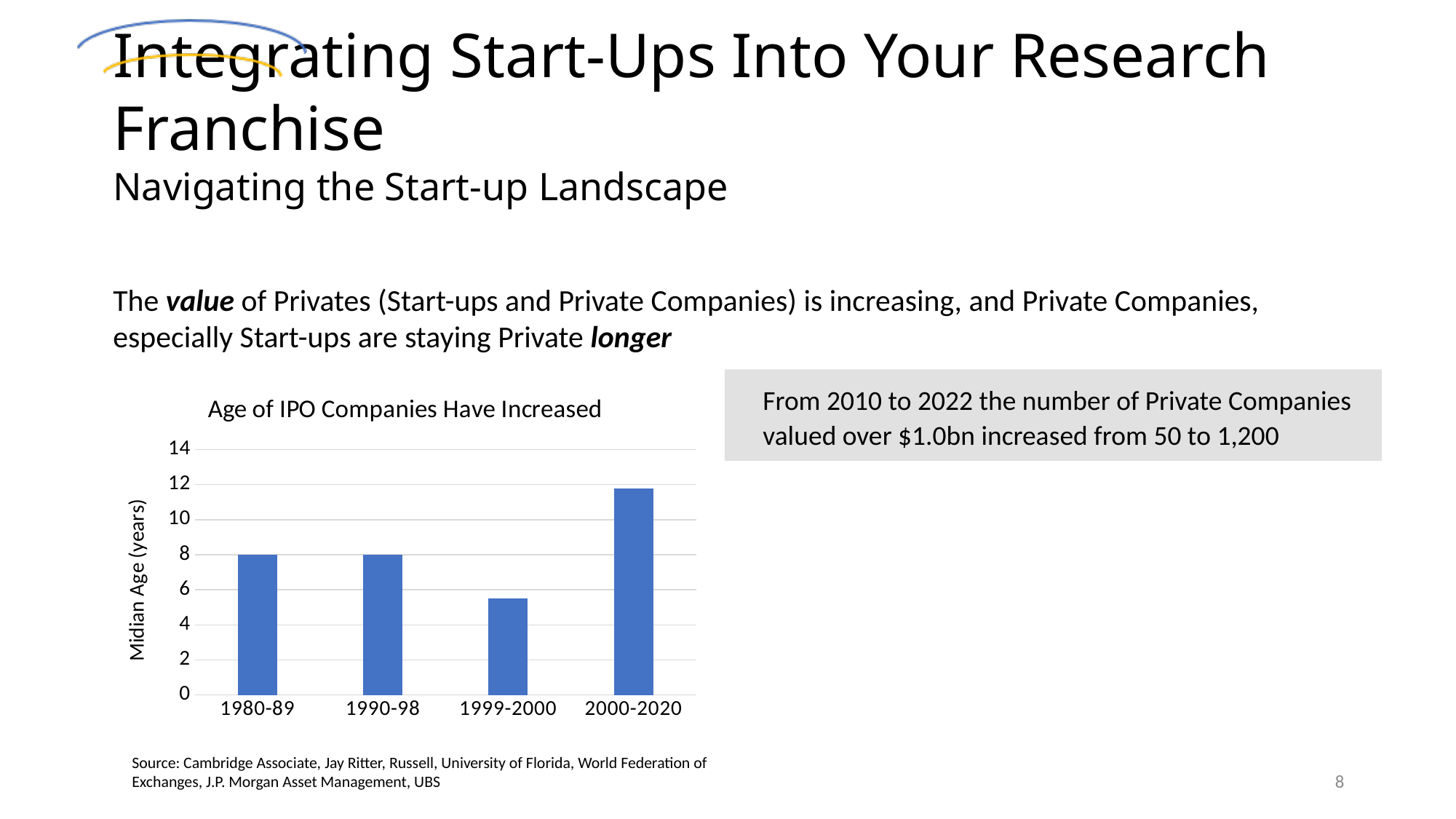
Which is larger, the value for 1999-2000 or the value for 2000-2020? 2000-2020 What is the median age (years) for 1980-89? 8 Which is larger, the value for 1980-89 or the value for 1999-2000? 1980-89 How many categories are shown on the x axis of the chart? 4 What is the median age (years) for 1990-98? 8 What type of chart is shown on the slide? Bar chart Is the value for 1999-2000 greater or less than 6? less Which period has the lowest median age? 1999-2000 What is the title of the chart? Age of IPO Companies Have Increased Is the value for 2000-2020 greater or less than 10? greater What is the label of the y axis of the chart? Midian Age (years) Which period has the highest median age? 2000-2020